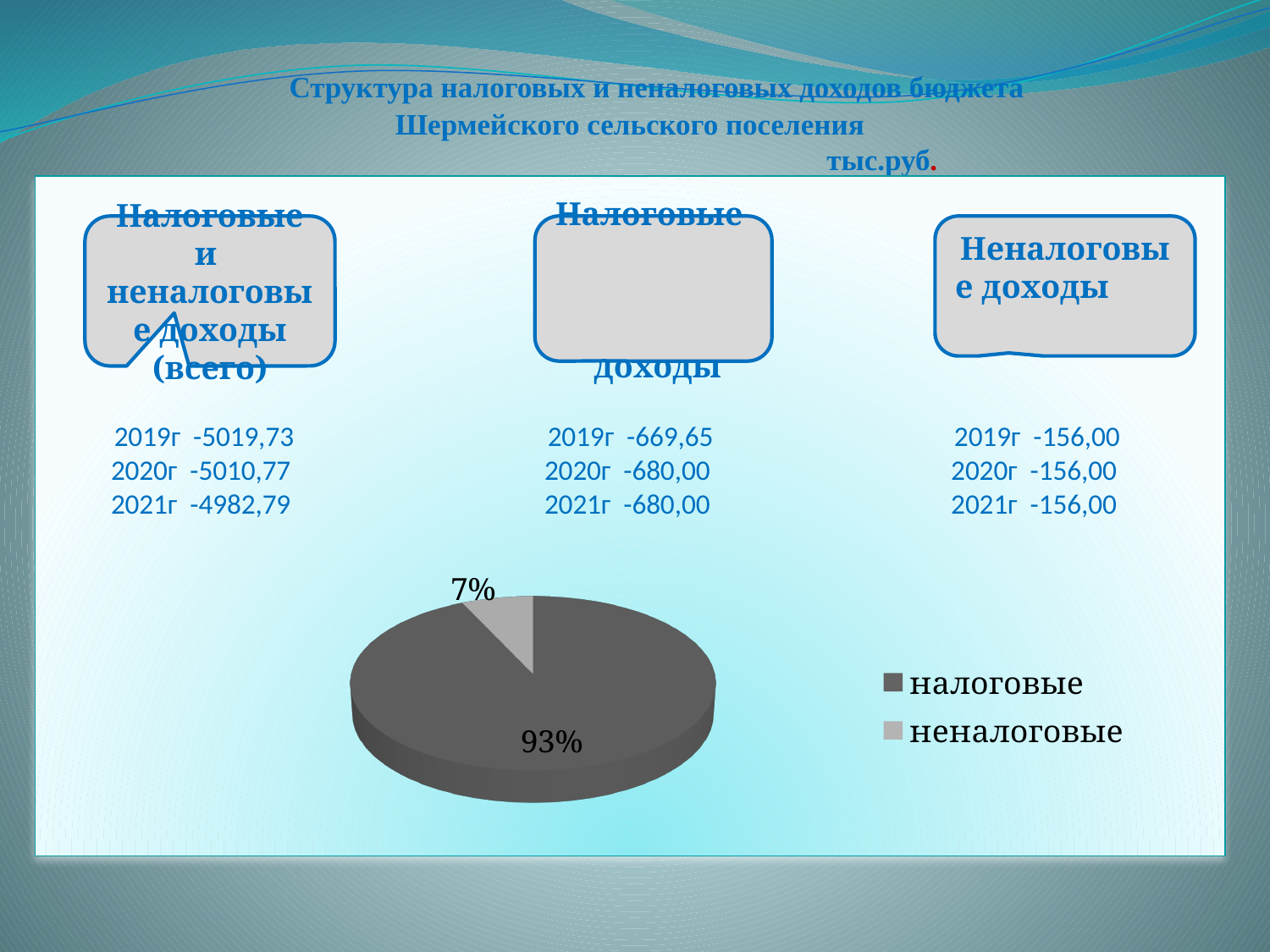
How many entries does the legend of the pie chart list? 2 What share of the pie does the "неналоговые" slice represent? 7% Which is larger in the pie chart, "налоговые" or "неналоговые"? налоговые By how many percentage points does the "налоговые" share exceed the "неналоговые" share? 86 Which slice of the pie chart is the largest? налоговые How many slices does the pie chart have? 2 What colour is the "неналоговые" slice in the pie chart? light grey Which slice of the pie chart is the smallest? неналоговые Is the share of "неналоговые" greater or less than 10%? less What kind of chart is shown on the slide? pie chart What are the two legend entries of the pie chart? налоговые, неналоговые What share of the pie does the "налоговые" slice represent? 93%